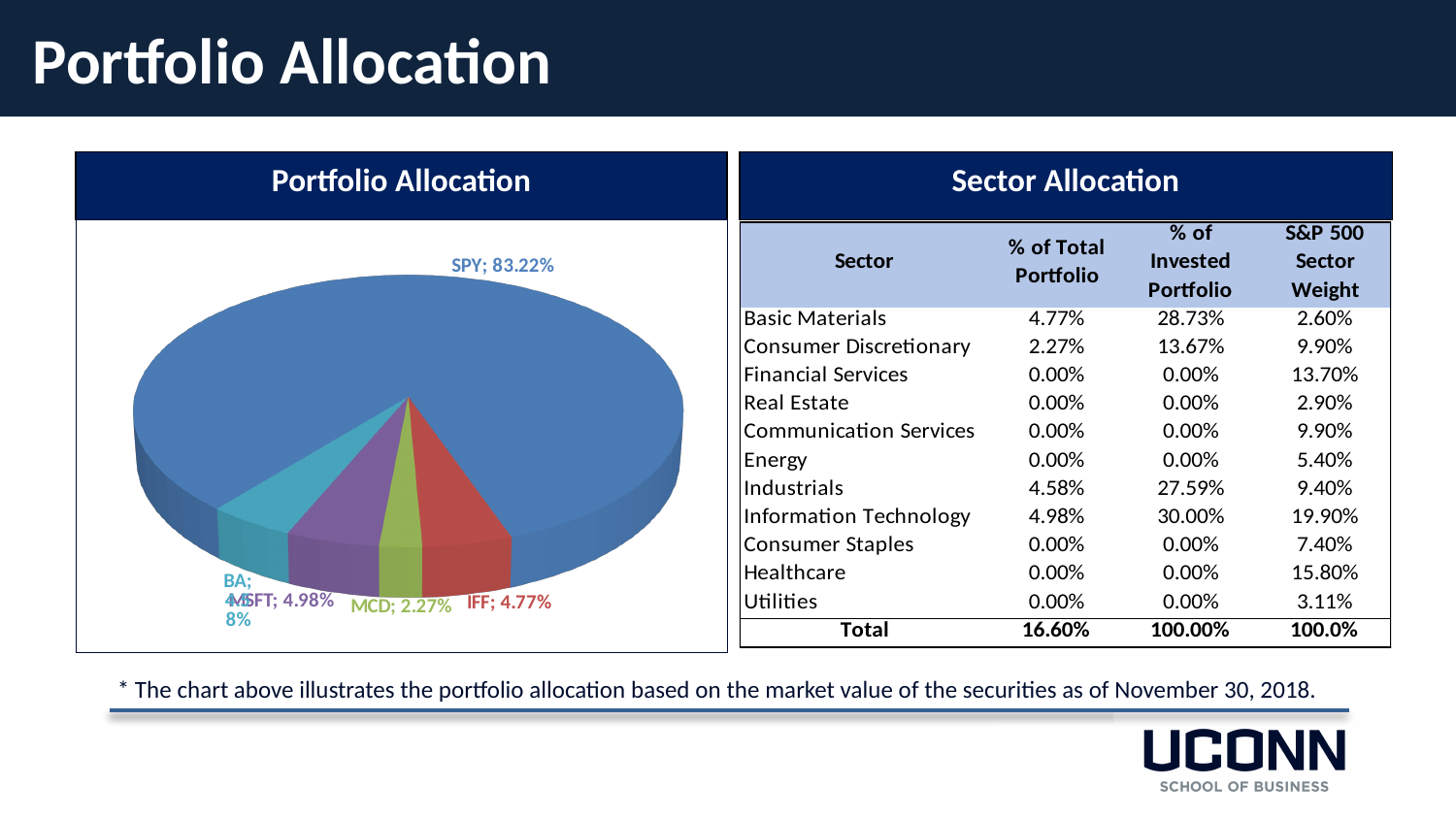
In the Portfolio Allocation pie chart, what is the value shown for IFF? 4.77% In the Portfolio Allocation pie chart, which is larger, the MSFT slice or the IFF slice? MSFT Which holding has the largest slice in the Portfolio Allocation pie chart? SPY In the Portfolio Allocation pie chart, what is the value shown for MSFT? 4.98% In the Portfolio Allocation pie chart, what share of the portfolio is SPY? 83.22% How many slices does the Portfolio Allocation pie chart have? 5 In the Portfolio Allocation pie chart, what is the value shown for MCD? 2.27% In the Portfolio Allocation pie chart, what is the difference between the IFF and MCD values? 2.50% In the Portfolio Allocation pie chart, what is the difference between the MSFT and IFF values? 0.21% Which holding has the smallest slice in the Portfolio Allocation pie chart? MCD What colour is the SPY slice in the Portfolio Allocation pie chart? Blue What kind of chart is the Portfolio Allocation chart? Pie chart